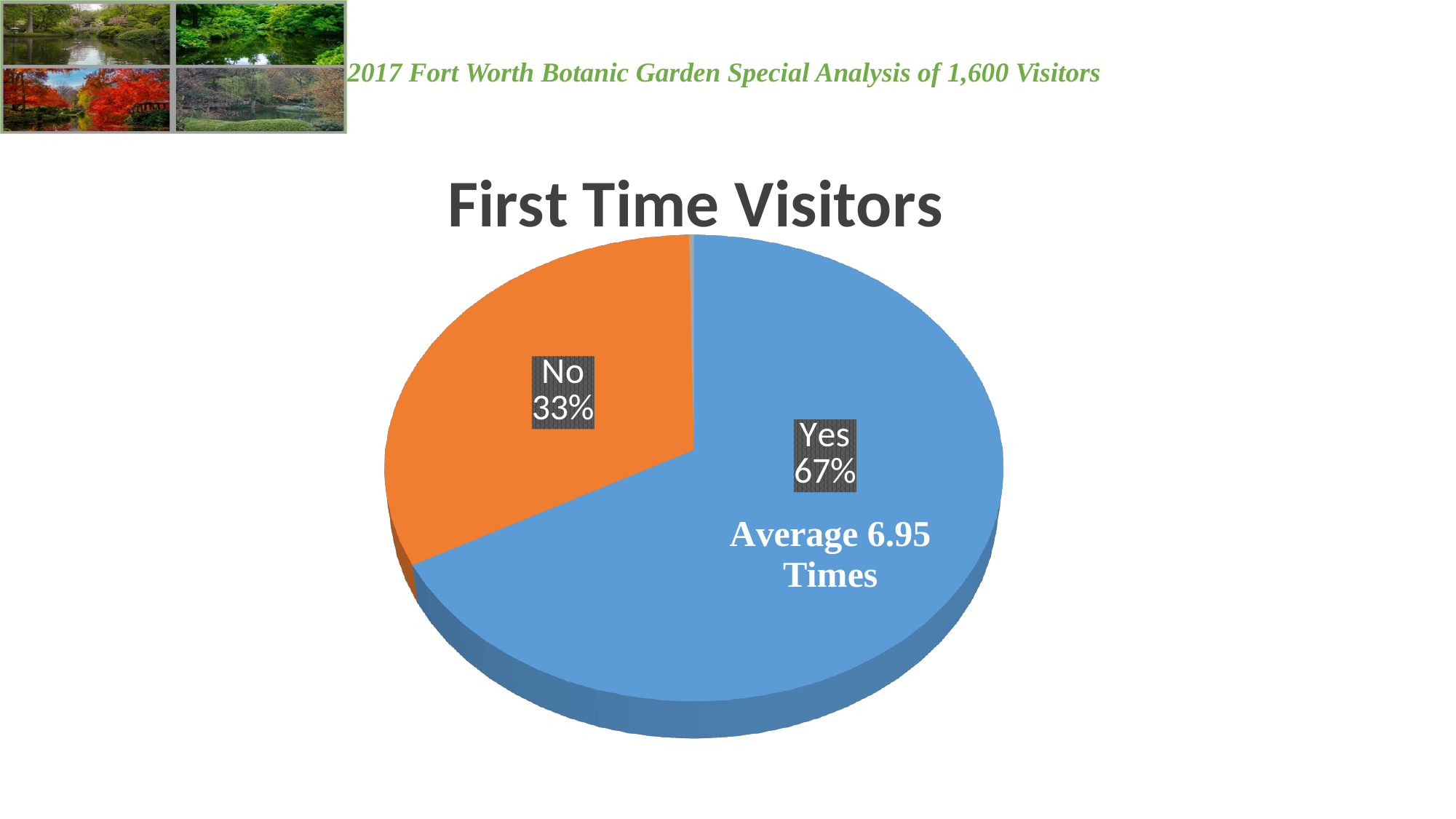
Which slice of the pie is the largest? Yes What share of the pie is labelled "No"? 33% What colour is the "No" slice? orange What is the difference in percentage points between the "Yes" and "No" slices? 34 What average number of times is printed on the "Yes" slice? Average 6.95 Times Which is larger, the "Yes" slice or the "No" slice? Yes What share of the pie is labelled "Yes"? 67% What is the title of the chart? First Time Visitors What kind of chart is shown on the slide? pie chart